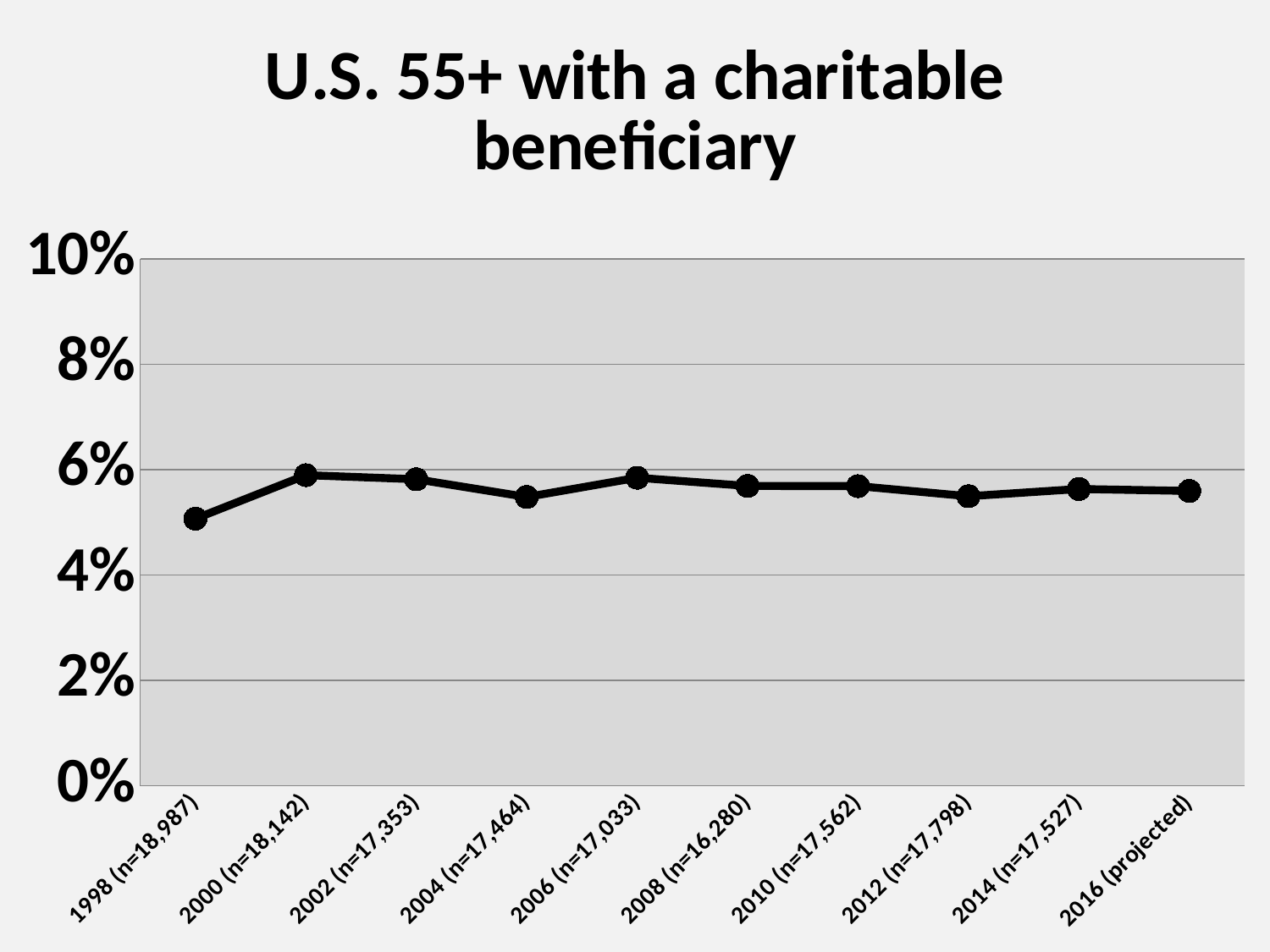
What kind of chart is shown on the slide? line chart What is the title of the chart? U.S. 55+ with a charitable beneficiary What is the highest value shown on the vertical axis? 10% How many data points are plotted on the line? 10 Which year has the lowest value on the chart? 1998 (n=18,987) Is the value for 1998 (n=18,987) greater or less than 6%? less Which is larger, the value for 2004 (n=17,464) or the value for 2006 (n=17,033)? 2006 (n=17,033) Is the value for 2000 (n=18,142) greater or less than 4%? greater What is the label of the last point on the x axis? 2016 (projected) Is the value for 2016 (projected) greater or less than 8%? less Which is larger, the value for 1998 (n=18,987) or the value for 2000 (n=18,142)? 2000 (n=18,142) Does the value rise or fall from 1998 to 2000? rise